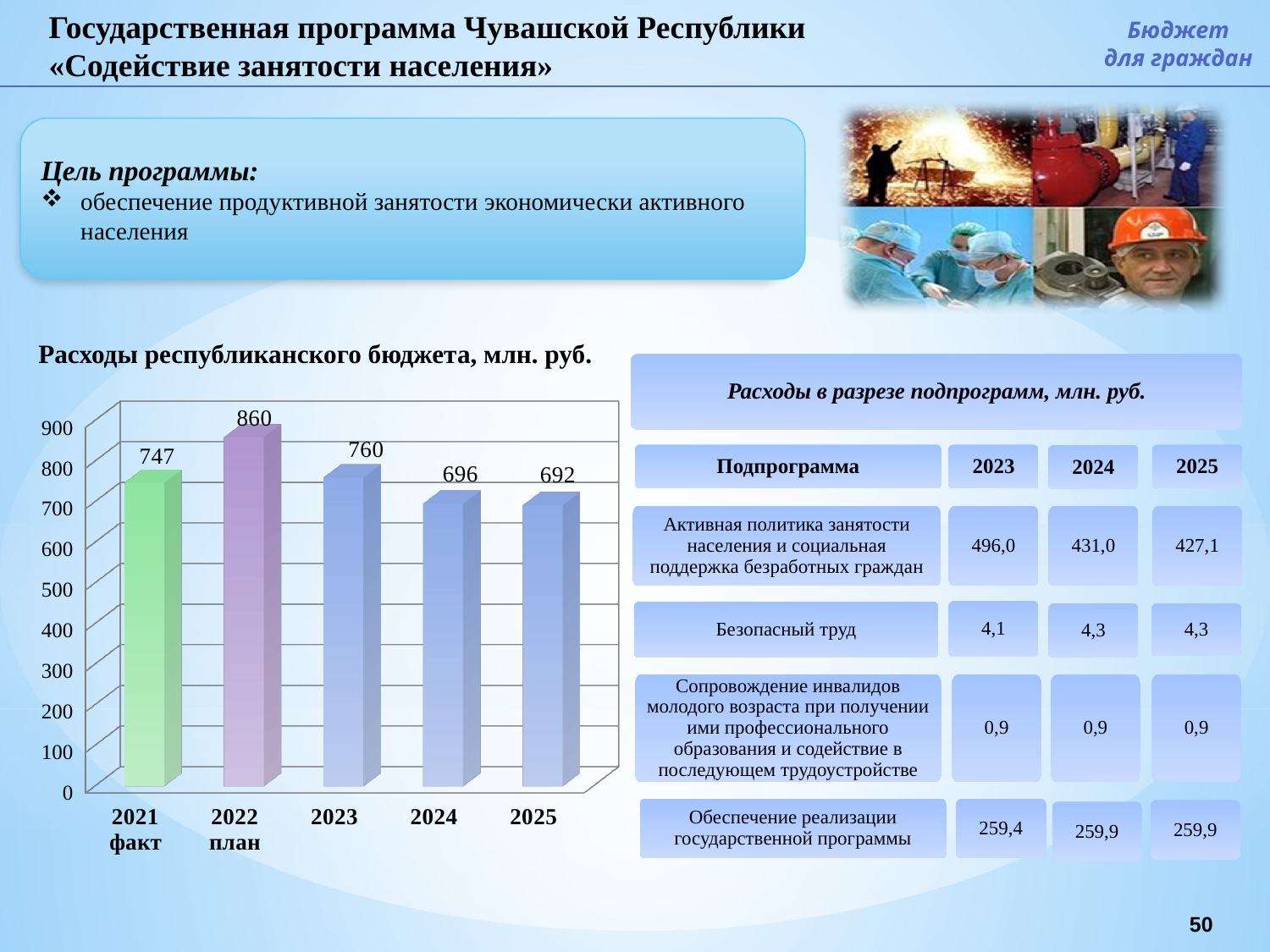
What is the difference between the values for 2022 план and 2023 in the chart 'Расходы республиканского бюджета, млн. руб.'? 100 Do the values rise or fall from 2022 план to 2025 in the chart 'Расходы республиканского бюджета, млн. руб.'? fall What is the difference between the values for 2024 and 2025 in the chart 'Расходы республиканского бюджета, млн. руб.'? 4 Which is larger in the chart 'Расходы республиканского бюджета, млн. руб.': the value for 2021 факт or the value for 2023? 2023 How many bars are shown in the chart 'Расходы республиканского бюджета, млн. руб.'? 5 Which year has the highest value in the chart 'Расходы республиканского бюджета, млн. руб.'? 2022 план What kind of chart is 'Расходы республиканского бюджета, млн. руб.'? bar chart What is the value for 2021 факт in the chart 'Расходы республиканского бюджета, млн. руб.'? 747 What is the value for 2025 in the chart 'Расходы республиканского бюджета, млн. руб.'? 692 Which year has the lowest value in the chart 'Расходы республиканского бюджета, млн. руб.'? 2025 What is the value for 2022 план in the chart 'Расходы республиканского бюджета, млн. руб.'? 860 Is the value for 2024 greater or less than 800 in the chart 'Расходы республиканского бюджета, млн. руб.'? less